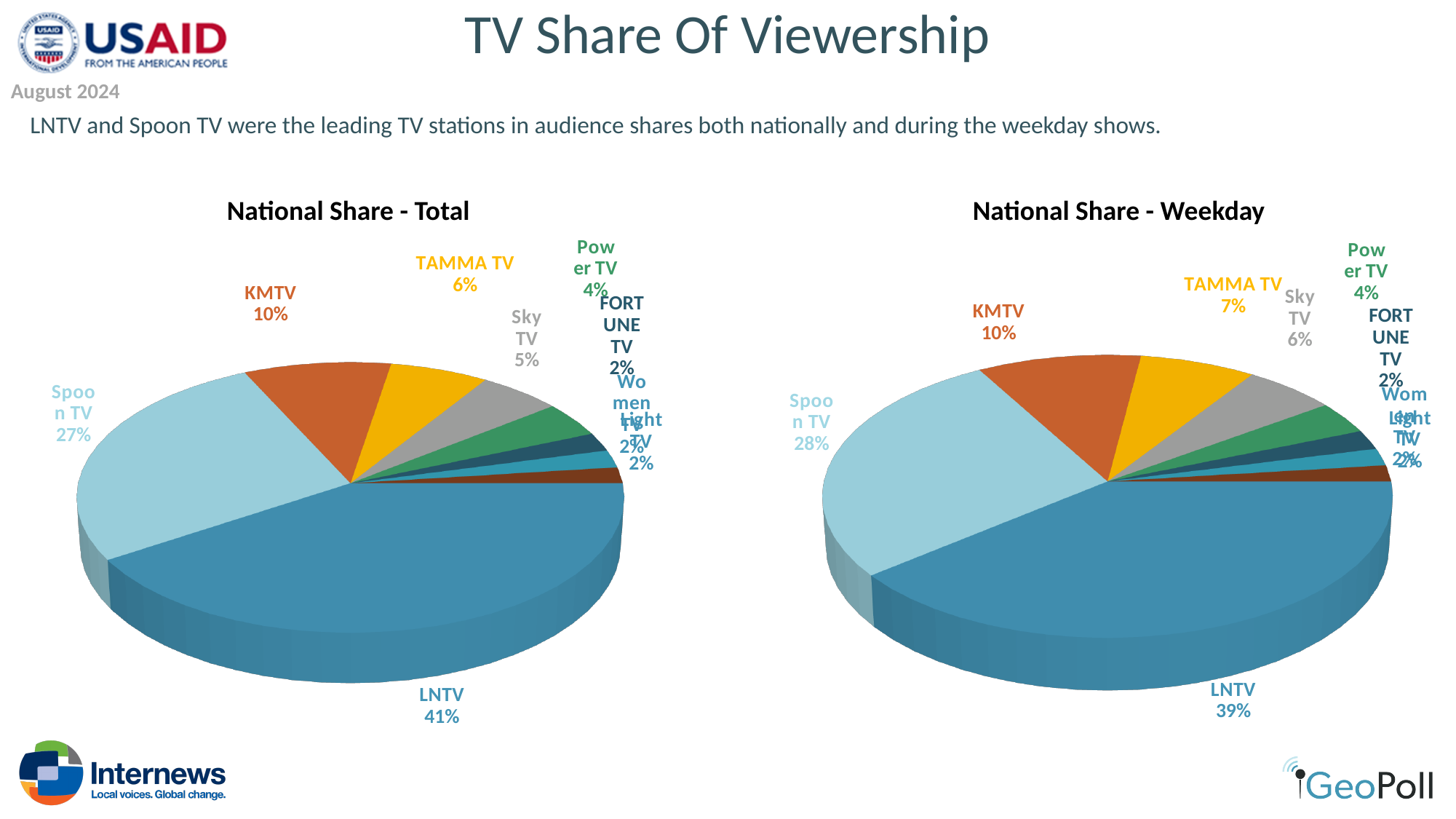
What is the title of the chart on the right side of the slide? National Share - Weekday In the National Share - Weekday chart, what share does Spoon TV have? 28% In the National Share - Weekday chart, what share does TAMMA TV have? 7% In the National Share - Total chart, what share does KMTV have? 10% In the National Share - Total chart, which is larger, the share for TAMMA TV or the share for Sky TV? TAMMA TV In the National Share - Total chart, what share does LNTV have? 41% In the National Share - Weekday chart, which station has the largest share? LNTV What kind of chart is the National Share - Total chart? Pie chart In the National Share - Weekday chart, what is the difference between the LNTV share and the Spoon TV share? 11% In the National Share - Weekday chart, what share does Power TV have? 4% In the National Share - Total chart, what is the difference between the LNTV share and the Spoon TV share? 14% In the National Share - Total chart, what share does Sky TV have? 5%